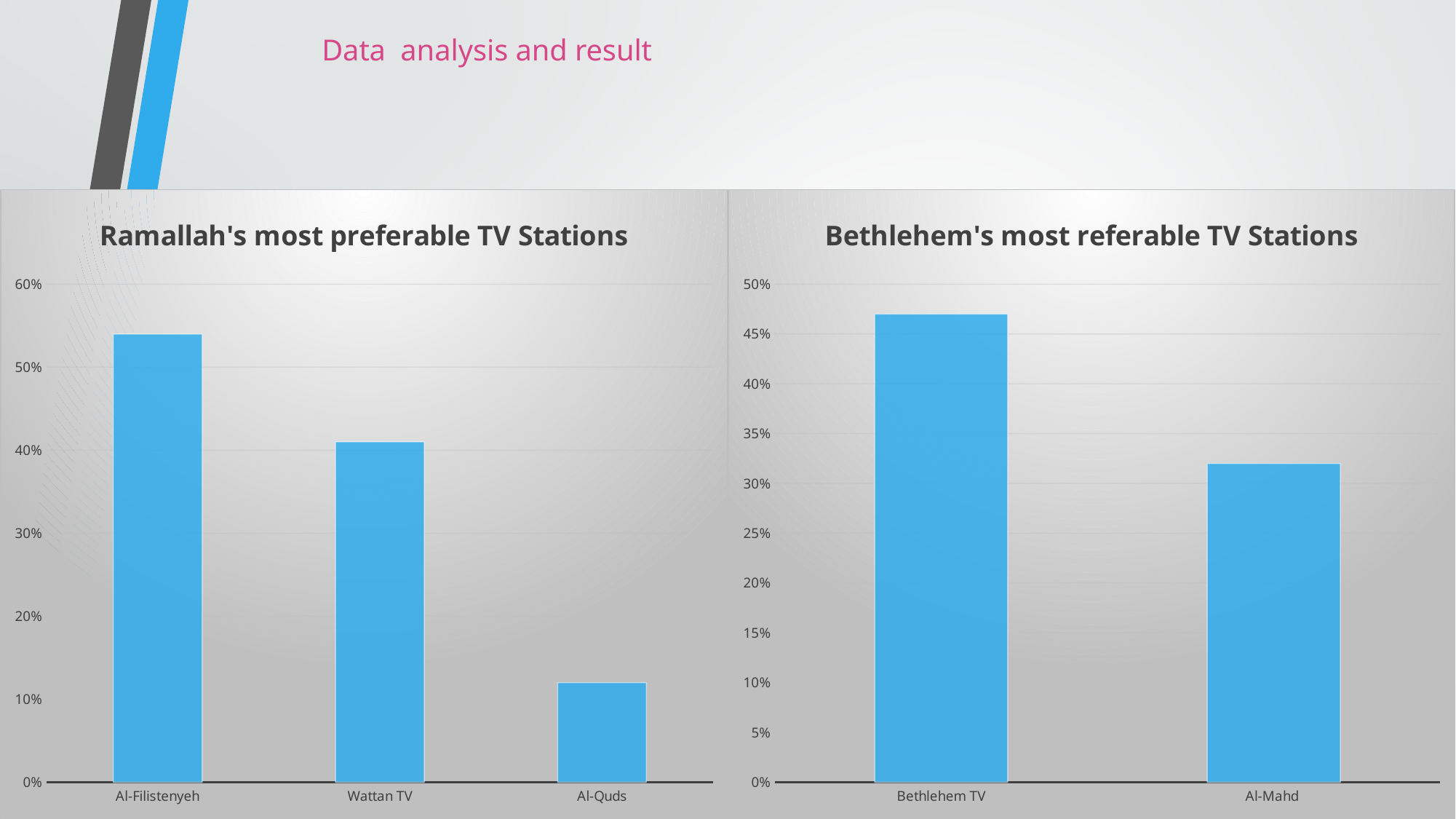
In 'Ramallah's most preferable TV Stations', which TV station has the lowest value? Al-Quds In 'Ramallah's most preferable TV Stations', is the value for Wattan TV greater or less than 30%? greater In 'Ramallah's most preferable TV Stations', is the value for Al-Filistenyeh greater or less than 50%? greater What kind of chart is 'Ramallah's most preferable TV Stations'? bar chart In 'Ramallah's most preferable TV Stations', do the values rise or fall from left to right along the x axis? fall In 'Bethlehem's most referable TV Stations', is the value for Bethlehem TV greater or less than 40%? greater How many TV stations are shown in 'Ramallah's most preferable TV Stations'? 3 In 'Ramallah's most preferable TV Stations', which TV station has the highest value? Al-Filistenyeh How many TV stations are shown in 'Bethlehem's most referable TV Stations'? 2 In 'Bethlehem's most referable TV Stations', which TV station has the higher value, Bethlehem TV or Al-Mahd? Bethlehem TV